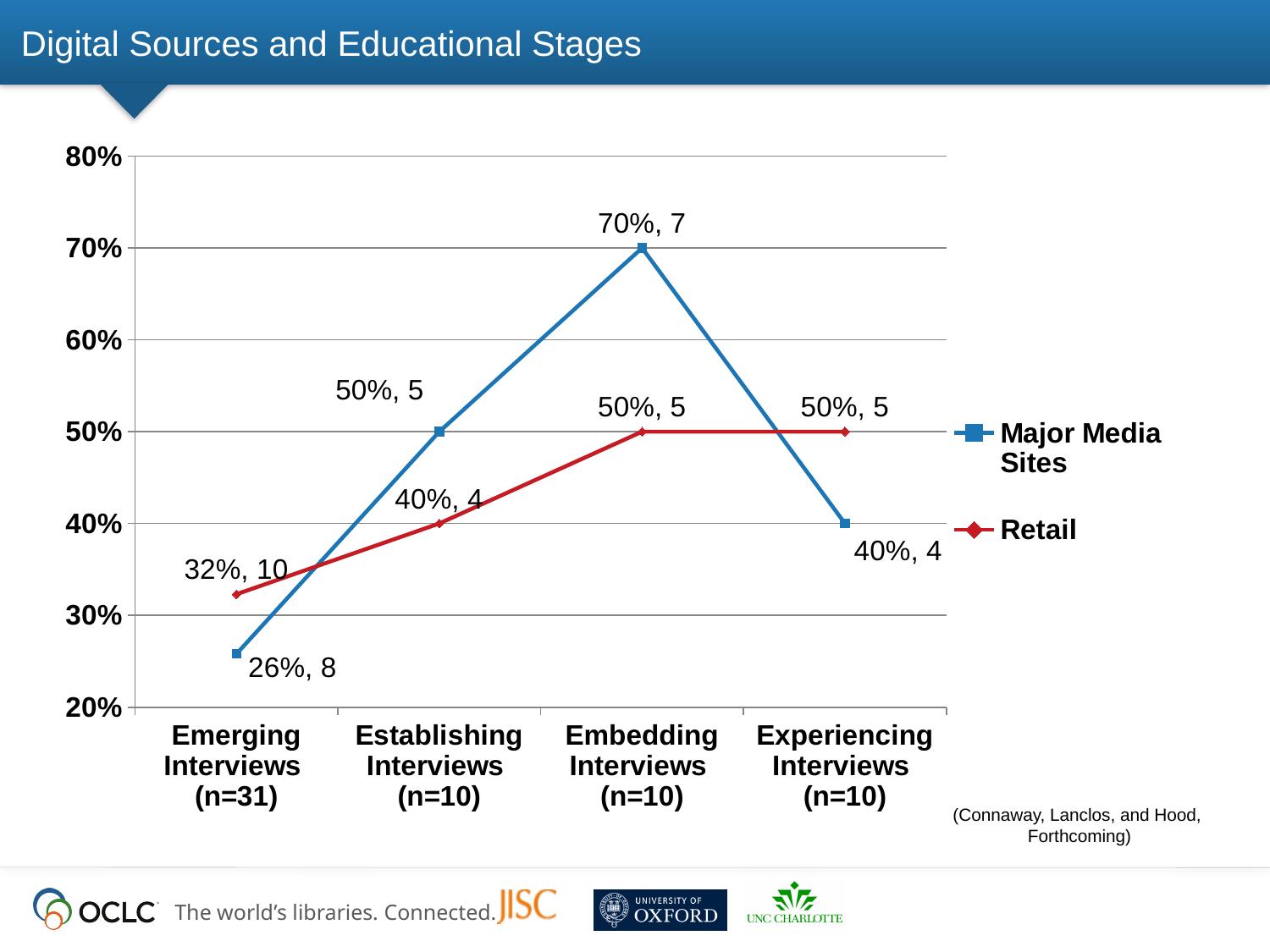
At which stage is the Major Media Sites value lowest? Emerging Interviews What is the percentage for Major Media Sites at the Experiencing Interviews stage? 40% What is the difference between the Major Media Sites and Retail percentages at the Embedding Interviews stage? 20% What is the sample size shown for the Emerging Interviews stage? n=31 How many series does the legend list? 2 What is the percentage for Retail at the Emerging Interviews stage? 32% Does the Retail line rise or fall from Emerging Interviews to Embedding Interviews? rise How many educational stages are plotted along the x axis? 4 What type of chart is shown on the slide? line chart What is the percentage for Major Media Sites at the Embedding Interviews stage? 70% At which stage is the Major Media Sites value highest? Embedding Interviews At the Experiencing Interviews stage, which series has the larger percentage, Major Media Sites or Retail? Retail